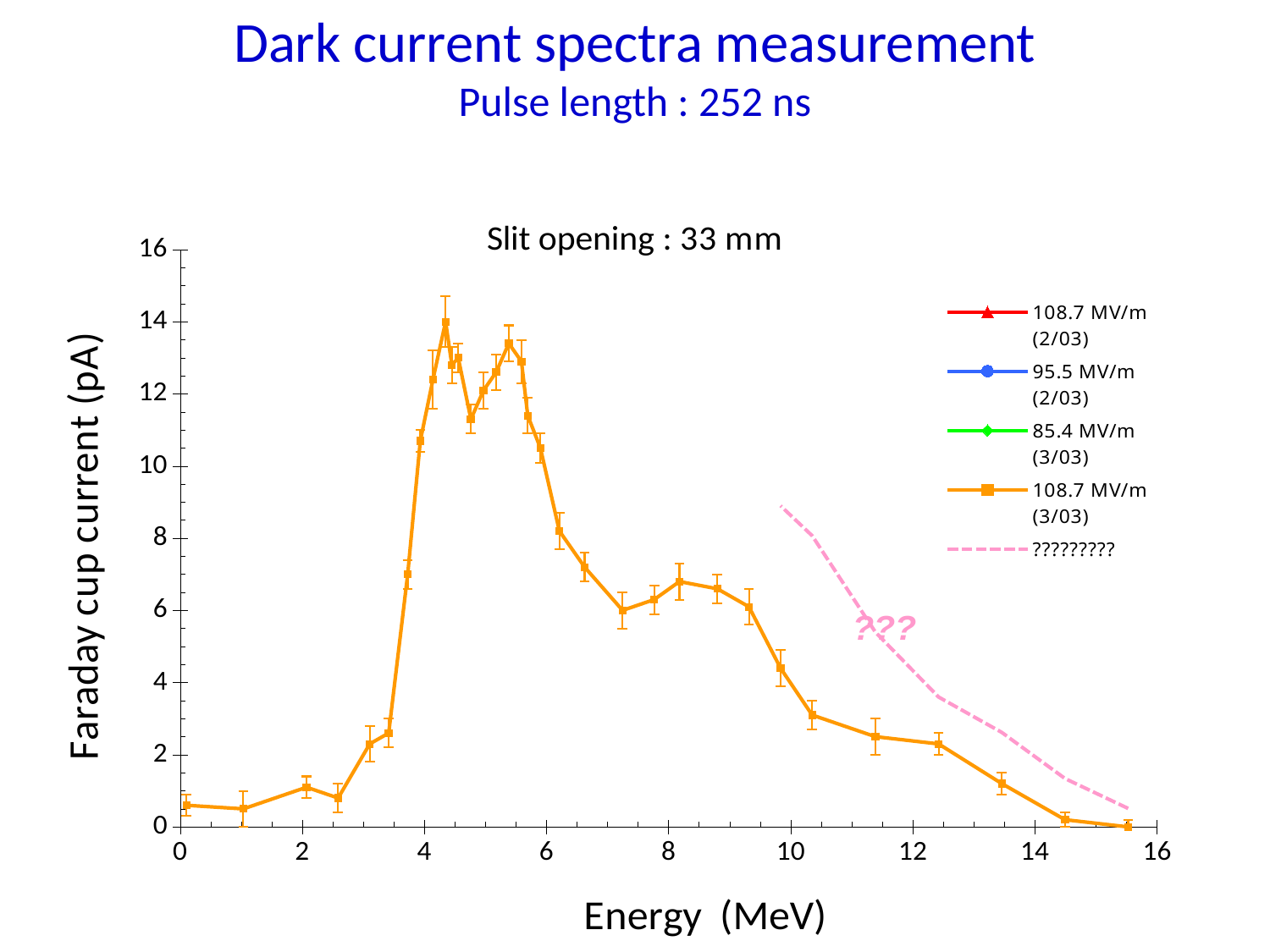
Is the Faraday cup current of the orange series at 12 MeV greater or less than 4 pA? less How many series does the legend list? 5 Is the Faraday cup current of the orange series at 8 MeV greater or less than 6 pA? greater Is the Faraday cup current of the orange series at 6 MeV greater or less than 8 pA? greater What kind of chart is shown on the slide? line chart Which legend entry corresponds to the orange line with square markers? 108.7 MV/m (3/03) Do the values of the orange series rise or fall as energy increases from 10 MeV to 14 MeV? fall What is the label of the y axis? Faraday cup current (pA) Do the values of the orange series rise or fall as energy increases from 2 MeV to 4 MeV? rise